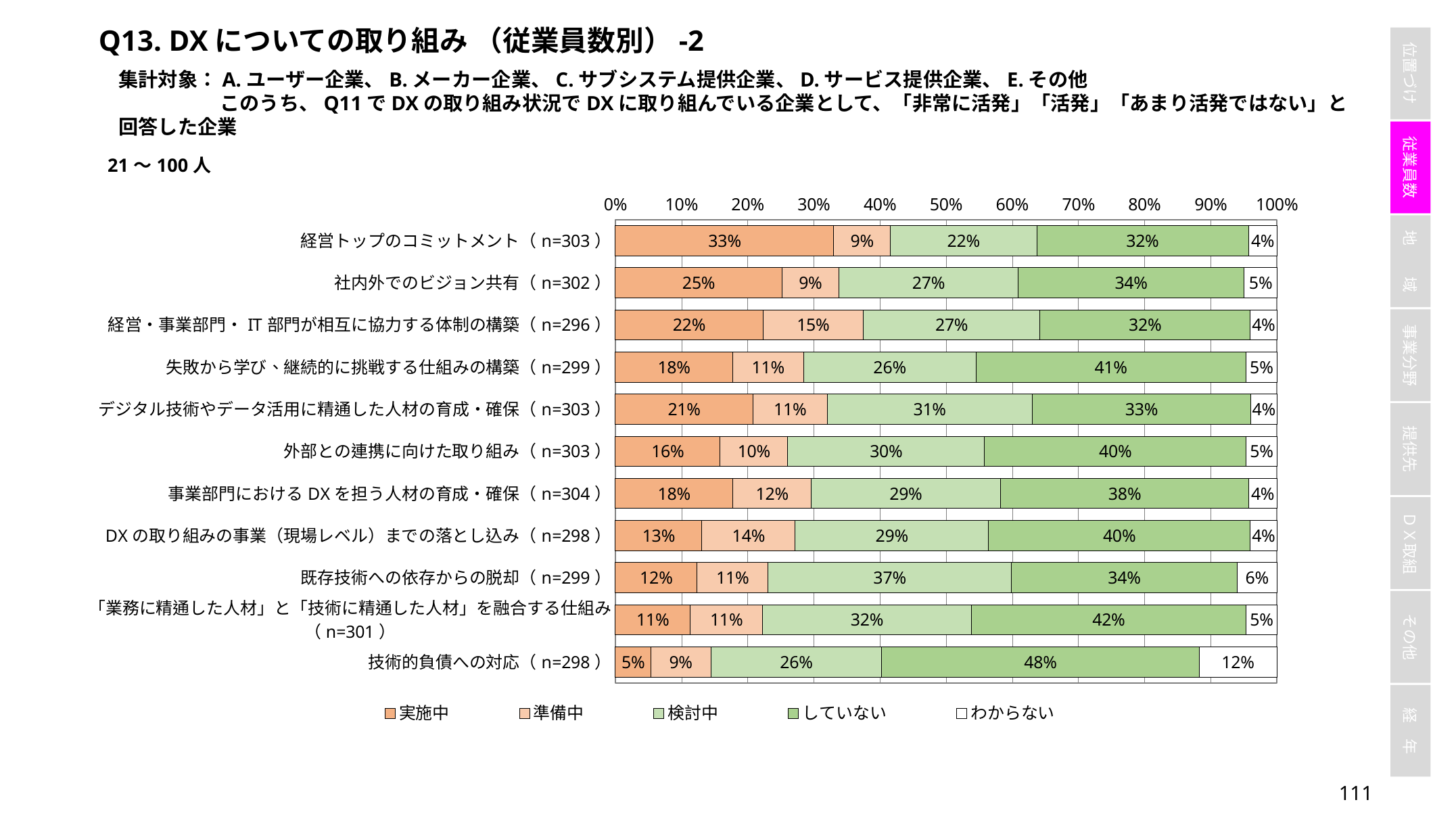
What is the 実施中 value for 経営トップのコミットメント? 33% What is the difference between the していない values for 技術的負債への対応 and 経営トップのコミットメント? 16% Which is larger: the 準備中 value for 経営・事業部門・IT部門が相互に協力する体制の構築 or for 社内外でのビジョン共有? 経営・事業部門・IT部門が相互に協力する体制の構築 How many categories (items) are plotted in the chart? 11 Which category has the lowest 実施中 value? 技術的負債への対応 Which category has the highest 実施中 value? 経営トップのコミットメント Which legend entry is shown in the darkest orange colour? 実施中 What kind of chart is shown on the slide? Stacked bar chart How many series does the legend list? 5 What is the 検討中 value for 既存技術への依存からの脱却? 37% What is the していない value for 技術的負債への対応? 48%